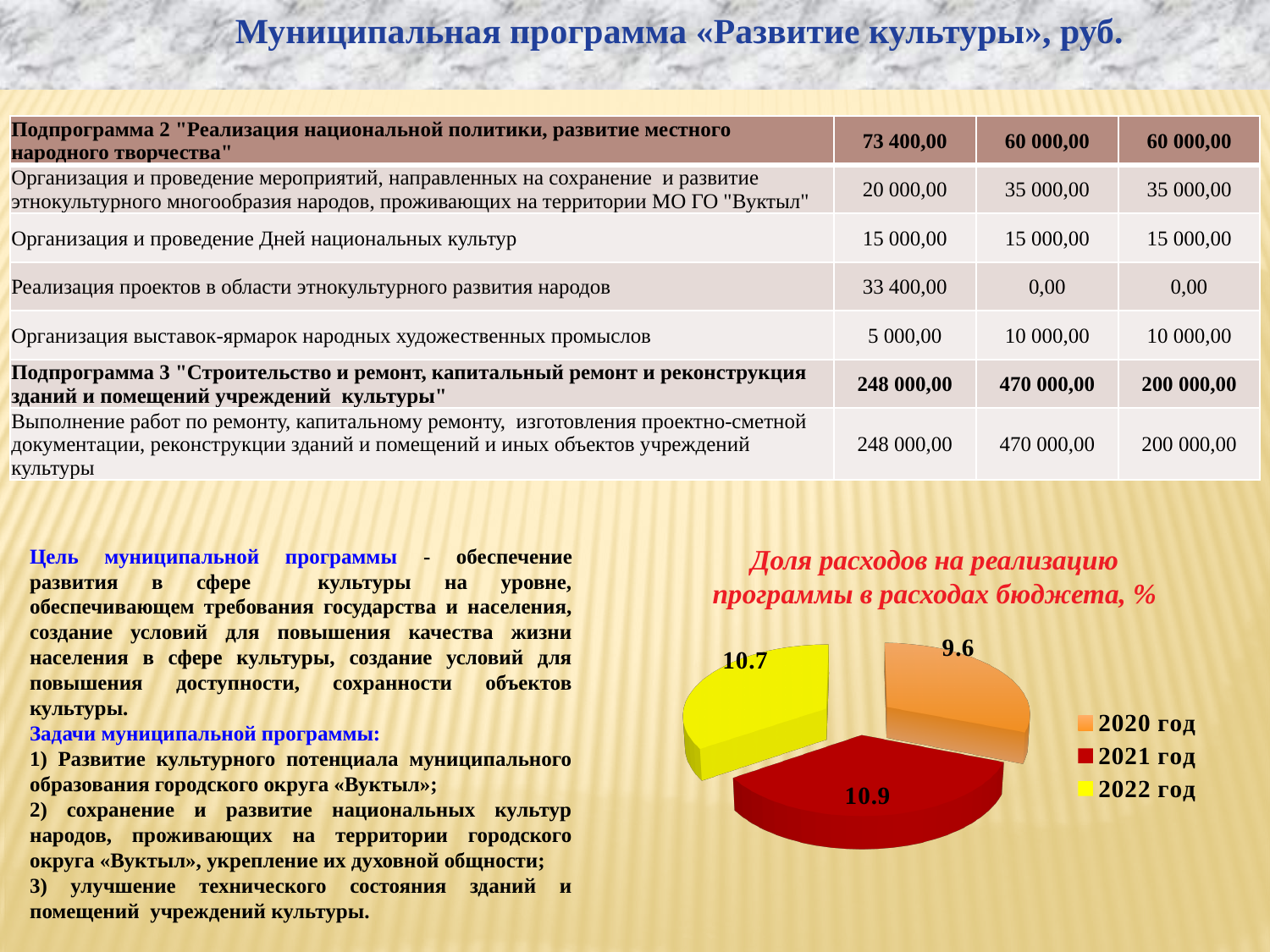
What is the value shown for 2021 год in the pie chart? 10.9 What is the value shown for 2022 год in the pie chart? 10.7 What is the value shown for 2020 год in the pie chart? 9.6 Which year has the smallest value in the pie chart? 2020 год What kind of chart is shown on the slide? pie chart What is the difference between the values for 2021 год and 2020 год in the pie chart? 1.3 Which year has the largest value in the pie chart? 2021 год Which is larger in the pie chart, the value for 2022 год or the value for 2020 год? 2022 год How many slices does the pie chart have? 3 Which colour represents 2022 год in the pie chart? yellow What is the difference between the values for 2022 год and 2020 год in the pie chart? 1.1 What is the title of the chart on the slide? Доля расходов на реализацию программы в расходах бюджета, %